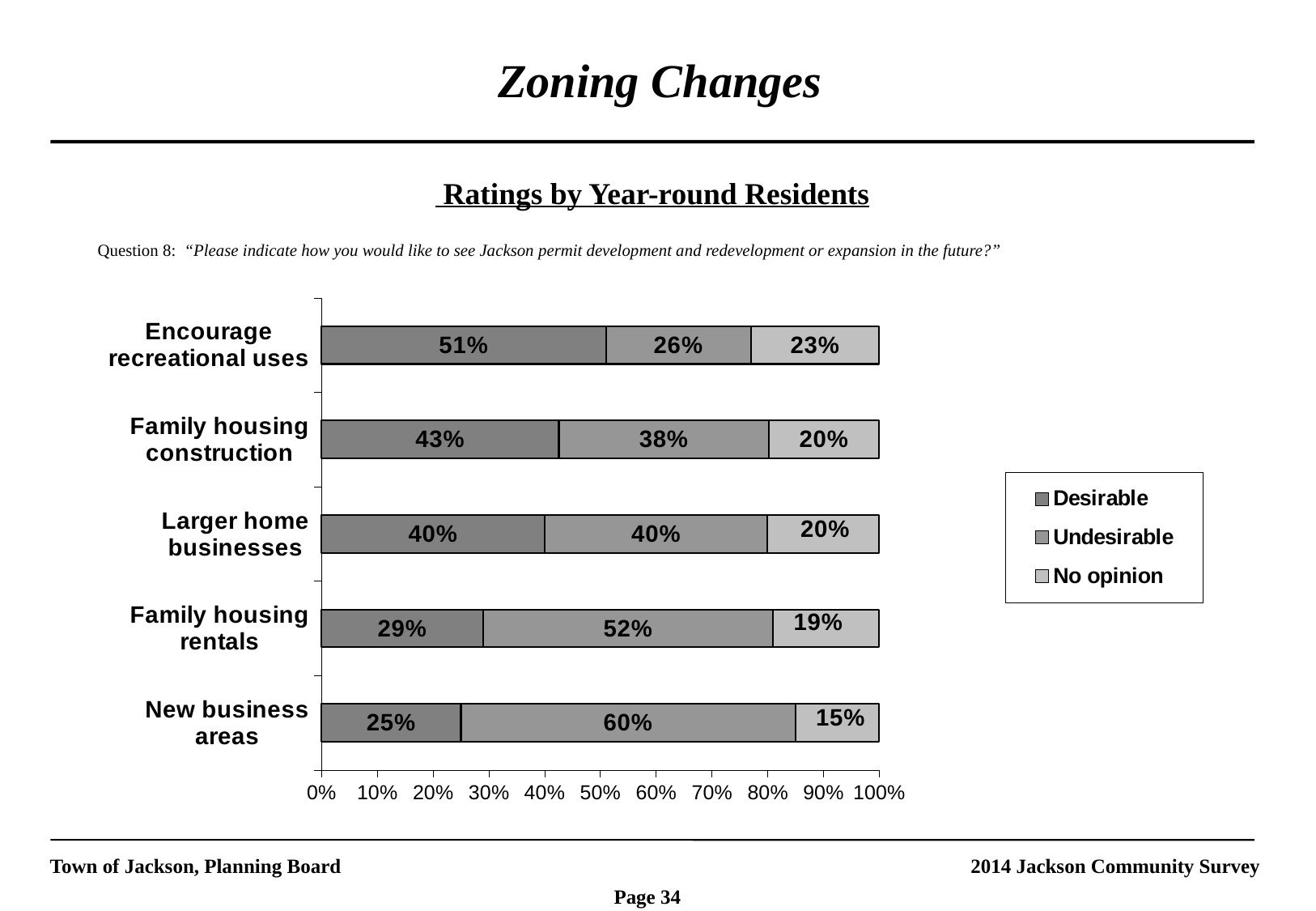
What percentage of year-round residents rated 'Encourage recreational uses' as Desirable? 51% Which category has the lowest Desirable percentage? New business areas How many categories are shown on the chart? 5 What is the Undesirable value for 'New business areas'? 60% What kind of chart is shown on the slide? Stacked bar chart What is the difference between the Undesirable and Desirable percentages for 'Family housing rentals'? 23% Which category has the highest Desirable percentage? Encourage recreational uses Which category has the highest Undesirable percentage? New business areas What are the three series listed in the legend? Desirable, Undesirable, No opinion How many series does the legend list? 3 Which is larger for 'Family housing construction': the Desirable or the Undesirable percentage? Desirable What is the No opinion value for 'Family housing rentals'? 19%